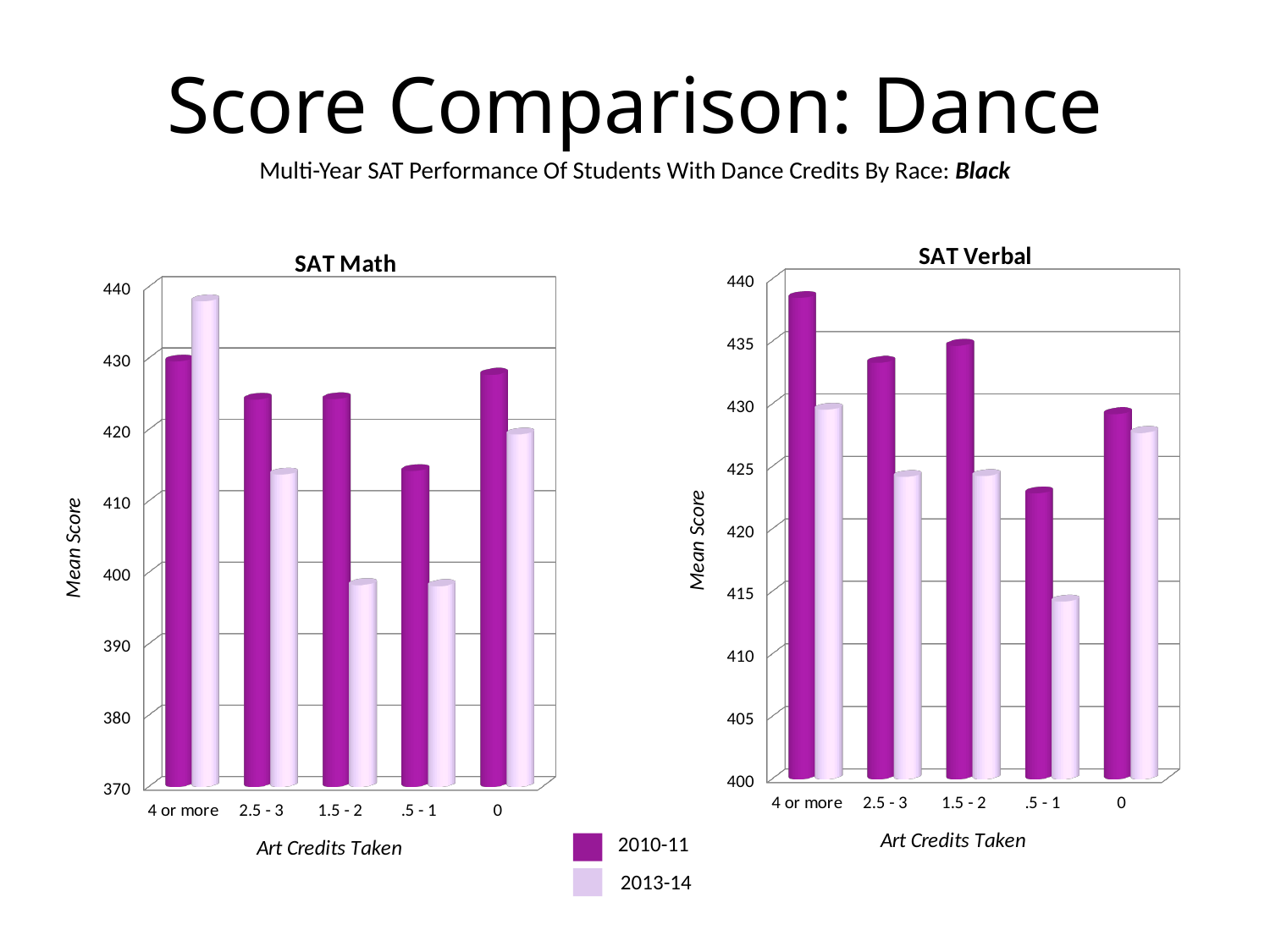
In the SAT Math chart, which art-credit category has the highest 2013-14 score? 4 or more In the SAT Verbal chart, which art-credit category has the highest 2010-11 score? 4 or more In the SAT Verbal chart, for the 4 or more category, which series has the larger value, 2010-11 or 2013-14? 2010-11 How many series does the legend list for the charts? 2 In the SAT Math chart, which art-credit category has the lowest 2010-11 score? .5 - 1 What kind of chart is the SAT Math chart? bar chart In the SAT Math chart, for the 4 or more category, which series has the larger value, 2010-11 or 2013-14? 2013-14 How many categories are shown on the x axis of the SAT Verbal chart? 5 In the SAT Math chart, is the 2013-14 value for 1.5 - 2 greater or less than 400? less What is the label on the y axis of the SAT Math chart? Mean Score In the SAT Verbal chart, is the 2010-11 value for .5 - 1 greater or less than 420? greater In the SAT Verbal chart, which art-credit category has the lowest 2013-14 score? .5 - 1